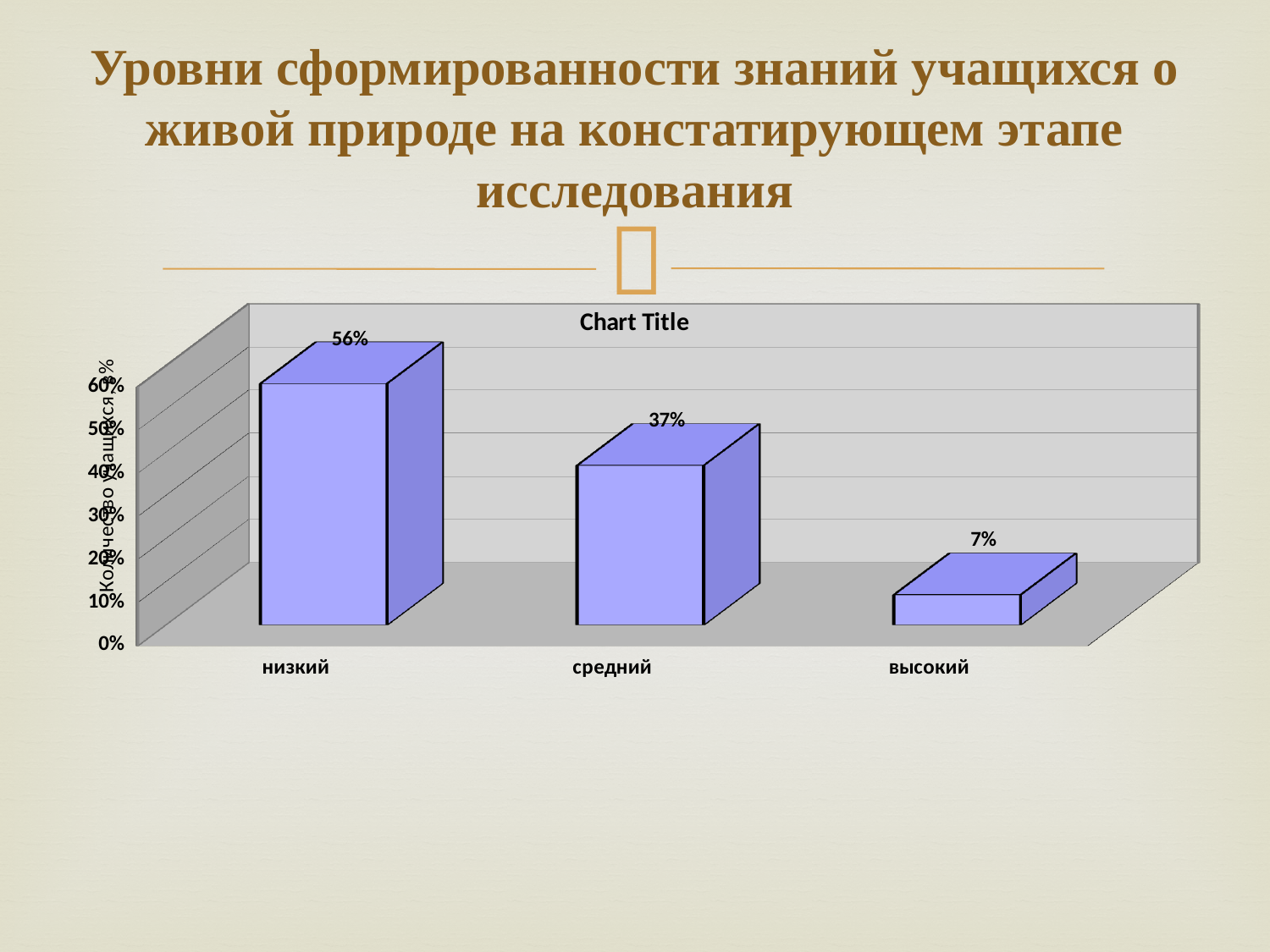
Do the values rise or fall from left to right along the x axis? fall What is the value for низкий? 56% What is the difference between the values for низкий and средний? 19% What is the difference between the values for средний and высокий? 30% Which category has the highest value? низкий How many categories are shown on the x axis? 3 What kind of chart is shown on the slide? bar chart What is the value for высокий? 7% What is the value for средний? 37% Is the value for низкий greater or less than 50%? greater Which category has the lowest value? высокий Which is larger, the value for средний or the value for высокий? средний